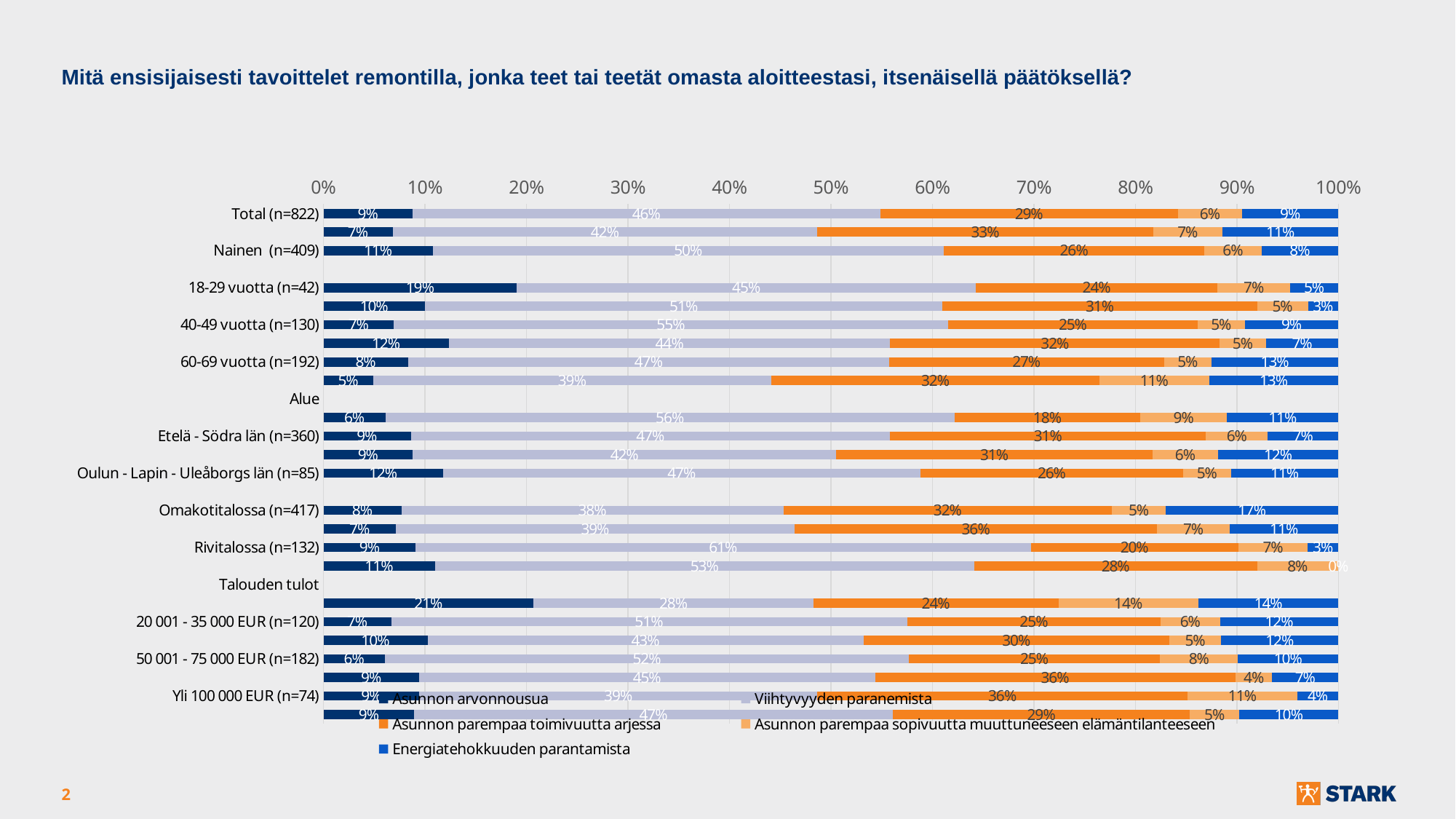
What is the value of Viihtyvyyden paranemista for Rivitalossa (n=132)? 61% What is the value of Asunnon arvonnousua for 18-29 vuotta (n=42)? 19% Which series has the smallest share in the Rivitalossa (n=132) bar? Energiatehokkuuden parantamista What kind of chart is shown on the slide? stacked bar chart How many series does the legend list? 5 Which is larger: Asunnon parempaa toimivuutta arjessa for Etelä - Södra län (n=360) or for Oulun - Lapin - Uleåborgs län (n=85)? Etelä - Södra län (n=360) What is the value of Viihtyvyyden paranemista for Total (n=822)? 46% What is the difference between Viihtyvyyden paranemista for Rivitalossa (n=132) and for Omakotitalossa (n=417)? 23% What is the value of Asunnon parempaa toimivuutta arjessa for Yli 100 000 EUR (n=74)? 36% Which series has the largest share in the Total (n=822) bar? Viihtyvyyden paranemista What is the value of Energiatehokkuuden parantamista for Omakotitalossa (n=417)? 17% What is the title of the chart? Mitä ensisijaisesti tavoittelet remontilla, jonka teet tai teetät omasta aloitteestasi, itsenäisellä päätöksellä?